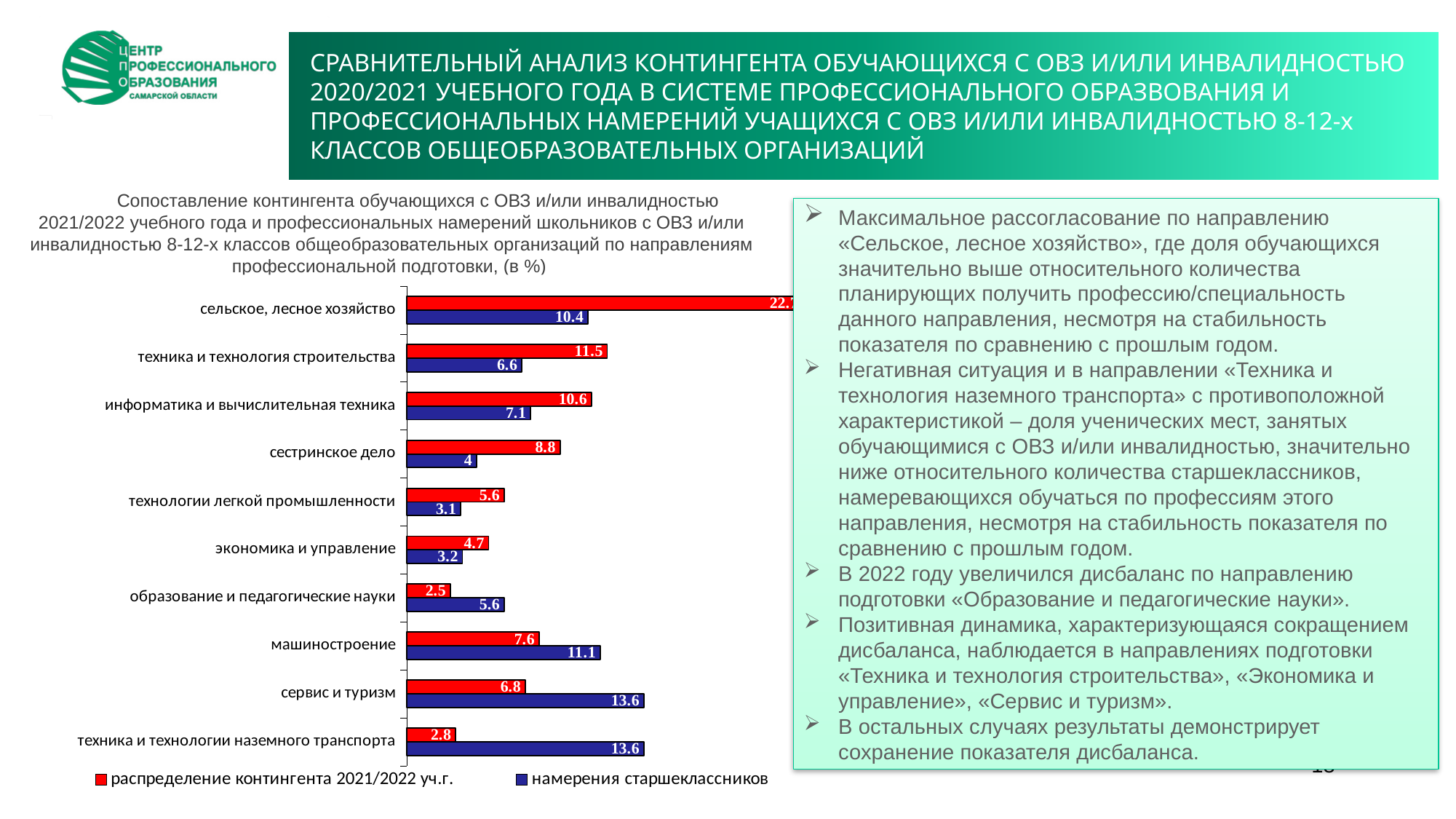
What is the value of 'распределение контингента 2021/2022 уч.г.' for 'техника и технологии наземного транспорта'? 2.8 How many series does the chart legend list? 2 What is the difference between 'намерения старшеклассников' and 'распределение контингента 2021/2022 уч.г.' for 'сервис и туризм'? 6.8 How many categories (directions of training) are shown in the chart? 10 What type of chart is shown on the slide? bar chart For 'машиностроение', which series has the larger value: 'распределение контингента 2021/2022 уч.г.' or 'намерения старшеклассников'? намерения старшеклассников What is the value of 'намерения старшеклассников' for 'сестринское дело'? 4 What is the value of 'распределение контингента 2021/2022 уч.г.' for 'техника и технология строительства'? 11.5 Which colour represents the series 'намерения старшеклассников' in the chart? blue Which category has the highest value for 'распределение контингента 2021/2022 уч.г.'? сельское, лесное хозяйство What is the value of 'намерения старшеклассников' for 'сельское, лесное хозяйство'? 10.4 Which category has the lowest value for 'намерения старшеклассников'? технологии легкой промышленности